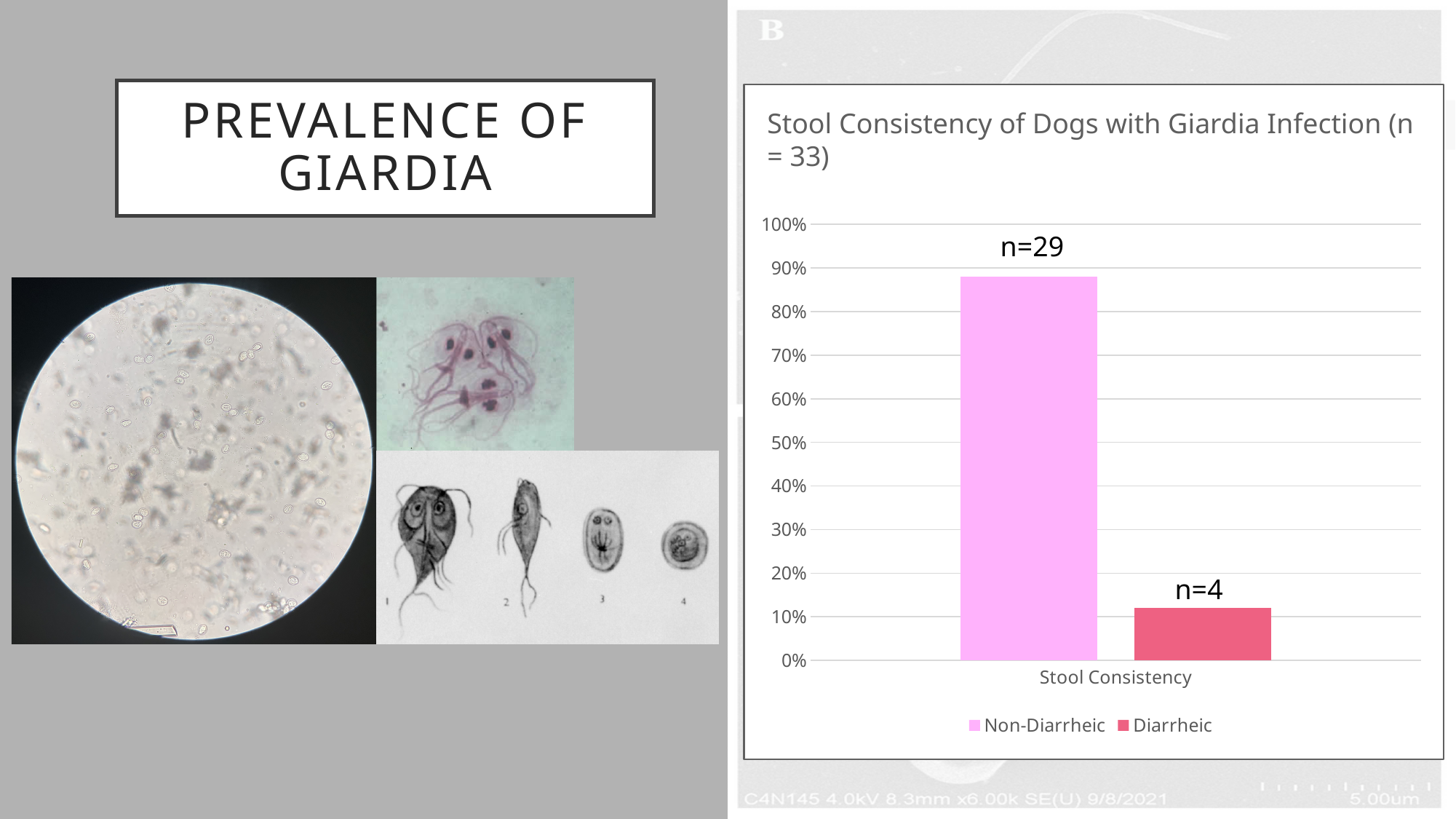
Which series has the lowest bar in the chart? Diarrheic What are the two series named in the chart legend? Non-Diarrheic and Diarrheic What data label is printed above the Diarrheic bar? n=4 Is the value for Diarrheic greater or less than 20%? less What data label is printed above the Non-Diarrheic bar? n=29 How many series does the chart legend list? 2 How many categories are shown on the x axis of the chart? 1 What is the title of the chart on the slide? Stool Consistency of Dogs with Giardia Infection (n = 33) What kind of chart is shown on the slide? bar chart Is the value for Non-Diarrheic greater or less than 80%? greater Which series has the taller bar, Non-Diarrheic or Diarrheic? Non-Diarrheic What is the difference in the number of dogs between the Non-Diarrheic (n=29) and Diarrheic (n=4) groups? 25